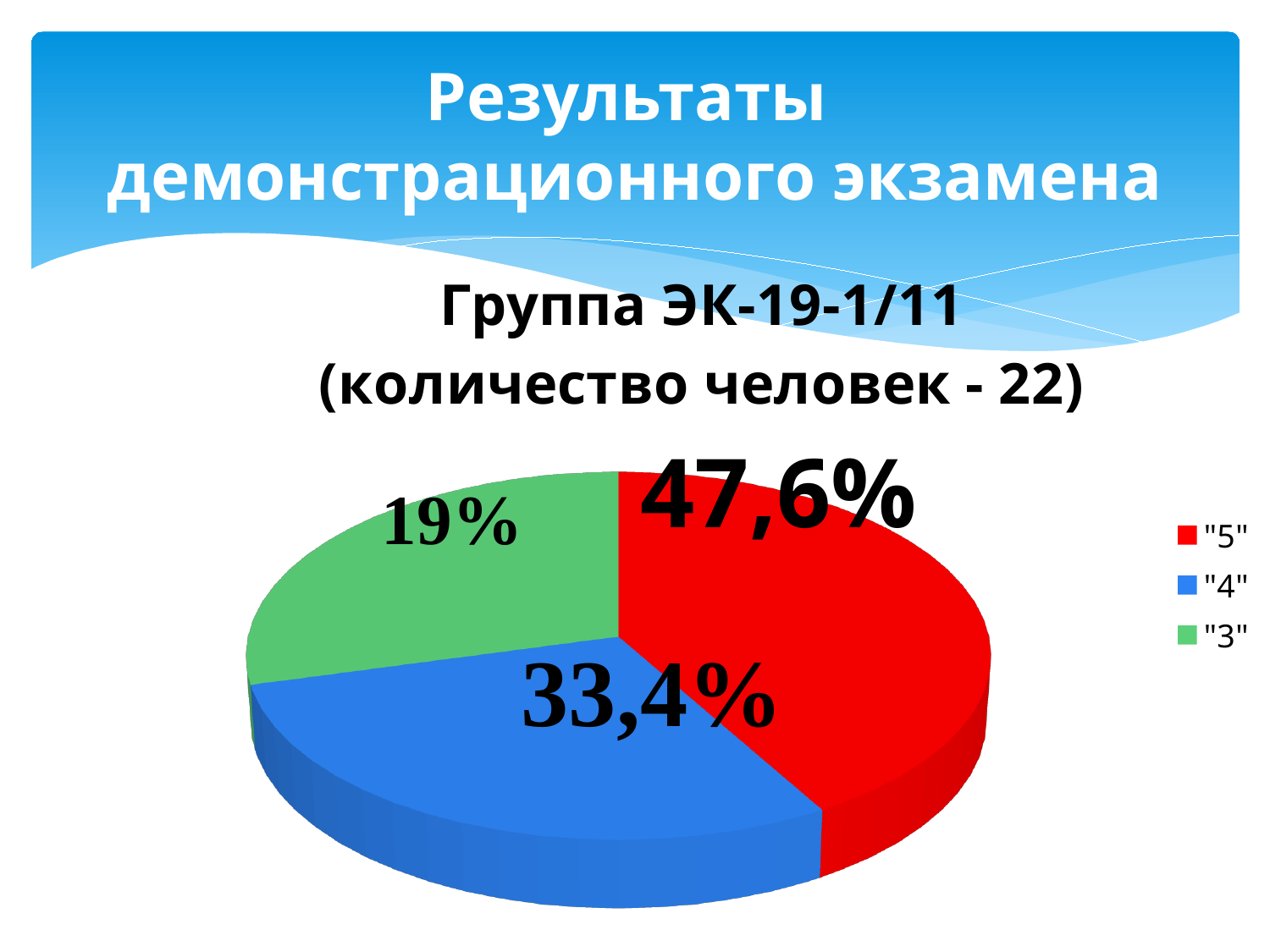
What is the difference in percentage points between the "5" slice and the "4" slice? 14,2 What colour is the slice for grade "4"? Blue How many slices does the pie chart have? 3 What share of the pie does the "5" slice represent? 47,6% Which slice is larger, "4" or "3"? "4" What share of the pie does the "3" slice represent? 19% What kind of chart is shown on the slide? Pie chart What is the difference in percentage points between the "4" slice and the "3" slice? 14,4 What share of the pie does the "4" slice represent? 33,4% Which grade has the smallest slice of the pie? "3" How many entries does the legend list? 3 Which grade has the largest slice of the pie? "5"